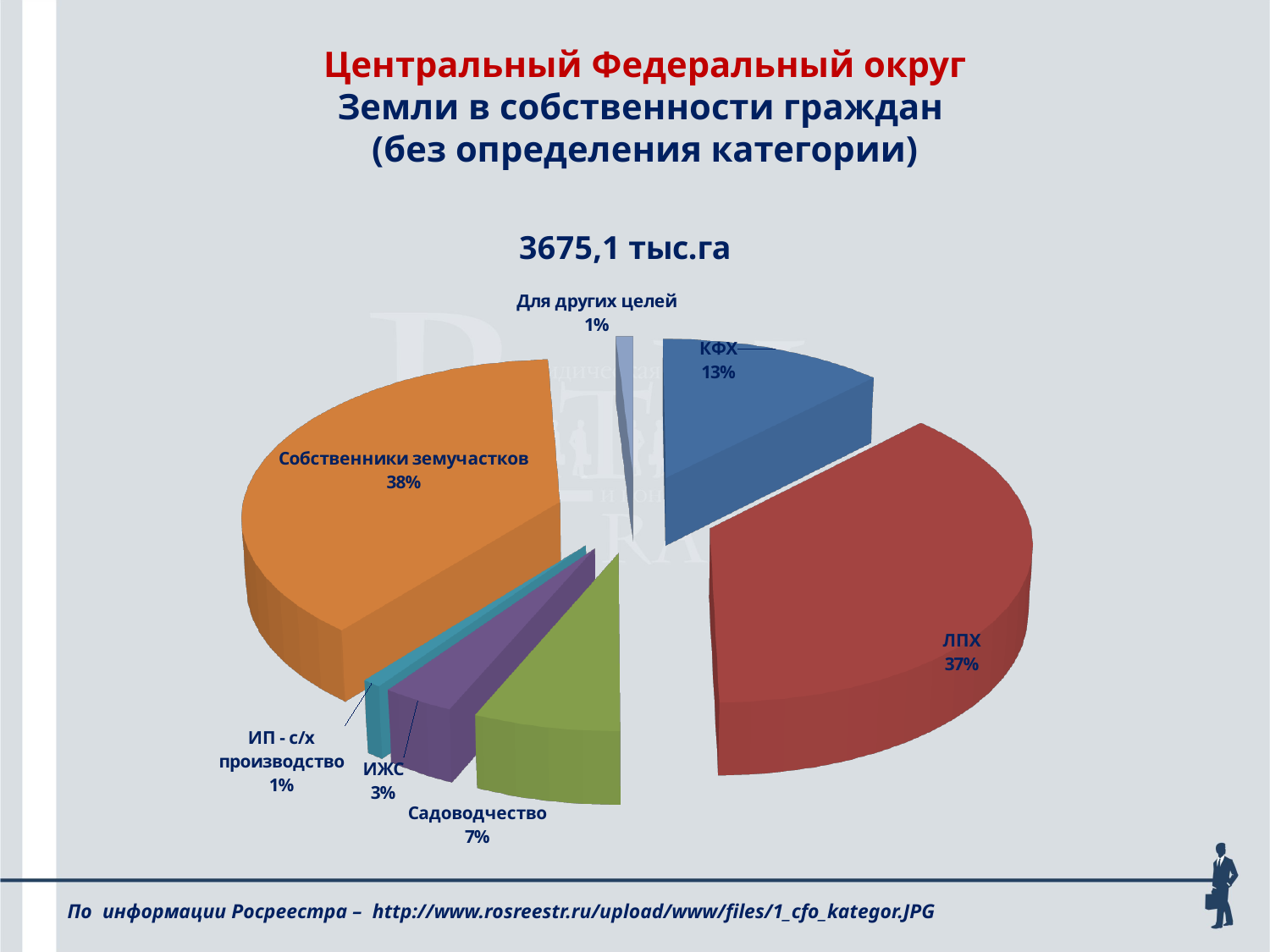
How many categories are shown in the pie chart? 7 What share of the pie does ЛПХ represent? 37% What share is shown for Собственники земучастков? 38% What share does Садоводчество have? 7% Which is larger, the share for КФХ or the share for Садоводчество? КФХ What percentage is shown for КФХ? 13% What type of chart is shown on the slide? Pie chart What is the difference between the shares of КФХ and ИЖС? 10% What percentage is labelled for ИЖС? 3% What total area is given in the chart title? 3675,1 тыс.га What is the difference in percentage points between Собственники земучастков and ЛПХ? 1% Which category has the largest share of the pie? Собственники земучастков